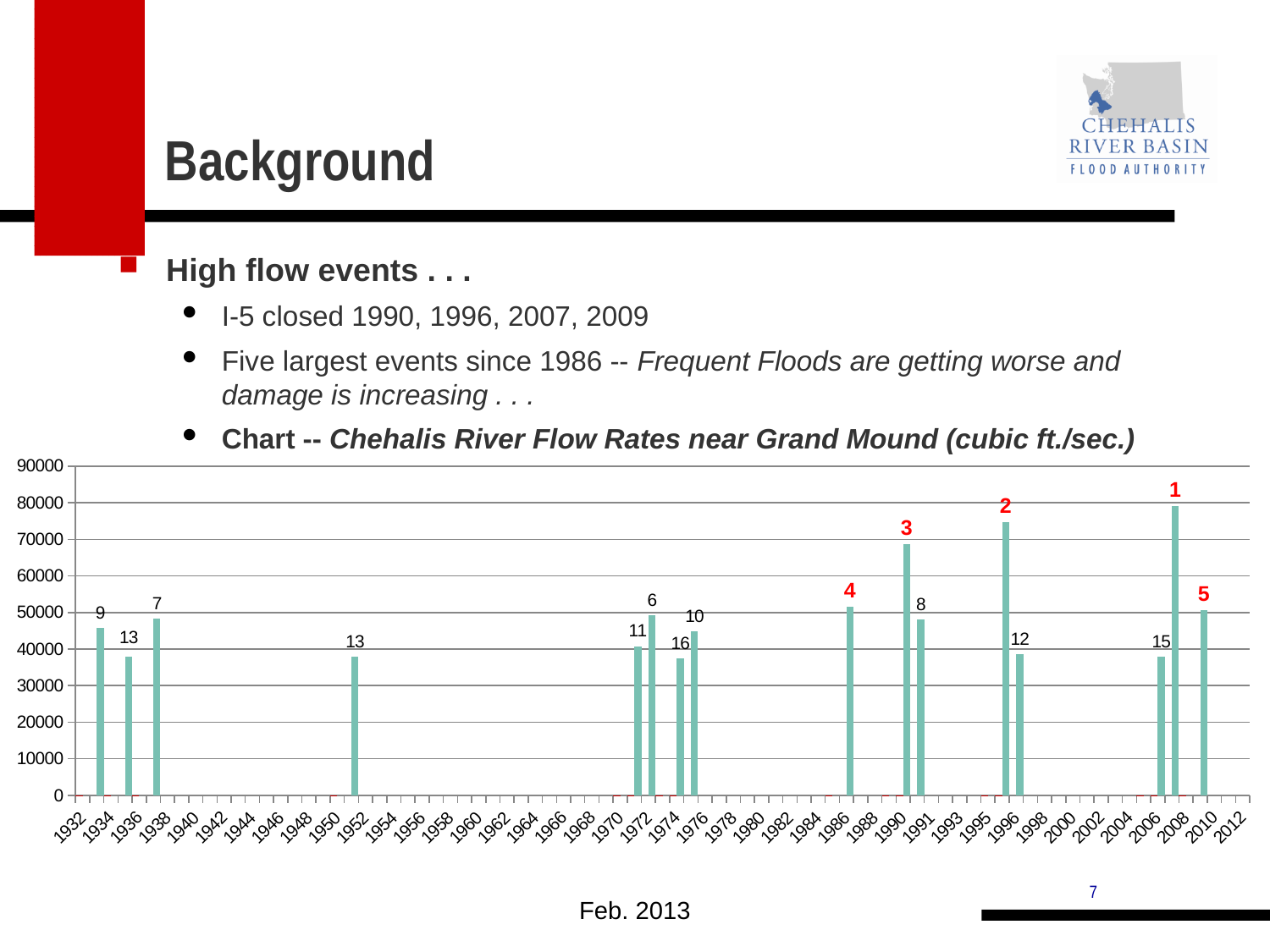
Is the value of the bar labeled 16 greater or less than 40000? less Is the value of the bar labeled 1 greater or less than 70000? greater Is the value of the bar labeled 3 greater or less than 60000? greater Which is larger, the bar labeled 2 or the bar labeled 3? the bar labeled 2 What is the highest value shown on the chart's vertical axis? 90000 How many bars (high flow events) are plotted in the chart? 16 What is the title of the chart, as given in the bullet text? Chehalis River Flow Rates near Grand Mound (cubic ft./sec.) Which bar is the tallest in the chart, by its printed rank label? the bar labeled 1 What kind of chart is shown on the slide? bar chart Which bar is the shortest in the chart, by its printed rank label? the bar labeled 16